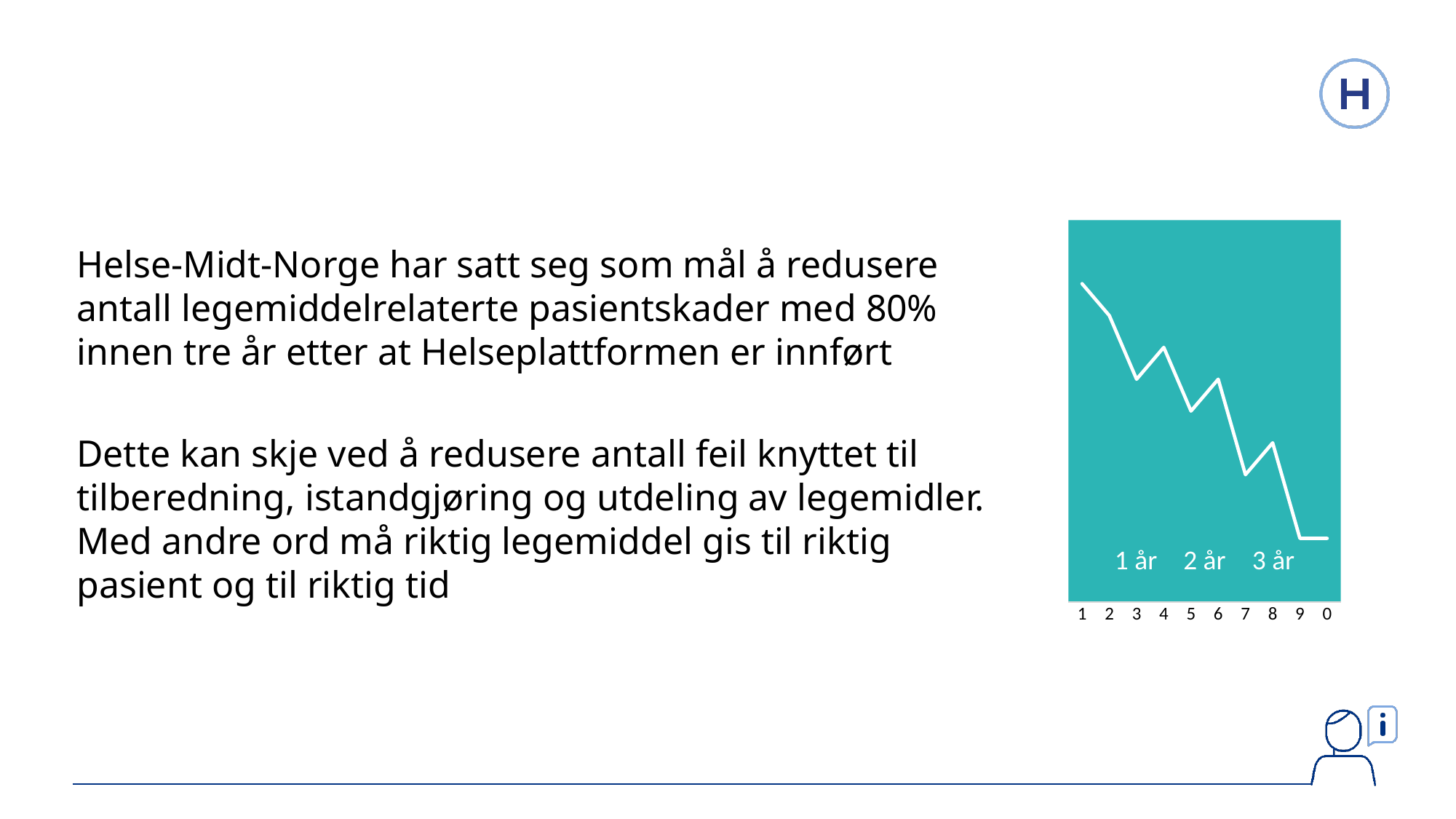
What kind of chart is shown on the right side of the slide? line chart Is the line at x-axis label 0 higher or lower than at x-axis label 1? lower What is the background colour of the chart area? teal At which x-axis label does the line reach its highest point? 1 Does the line in the chart generally rise or fall from left to right? fall What are the three year labels printed inside the chart area? 1 år, 2 år, 3 år How many tick labels are shown along the x axis of the chart? 10